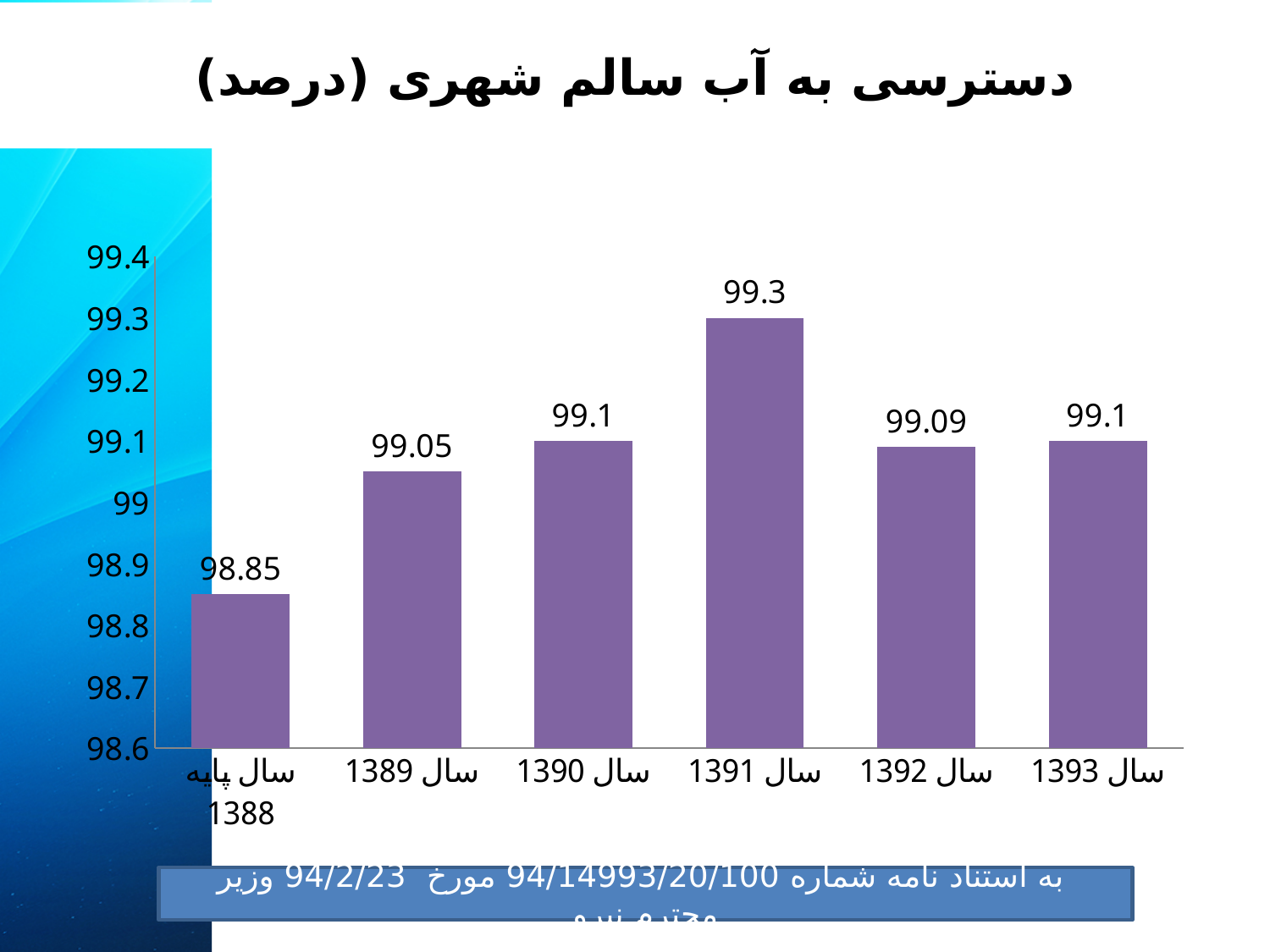
What is the title of the chart? دسترسی به آب سالم شهری (درصد) What is the value for the base year (سال پایه 1388)? 98.85 What is the difference between the values for سال 1391 and سال پایه 1388? 0.45 Which year has the highest value? سال 1391 What kind of chart is shown on the slide? Bar chart What is the value for سال 1391? 99.3 What is the value for سال 1389? 99.05 Which year has the lowest value? سال پایه 1388 Which is larger, the value for سال 1391 or the value for سال 1393? سال 1391 What is the value for سال 1392? 99.09 What is the difference between the values for سال 1390 and سال 1389? 0.05 How many years (bars) are shown in the chart? 6